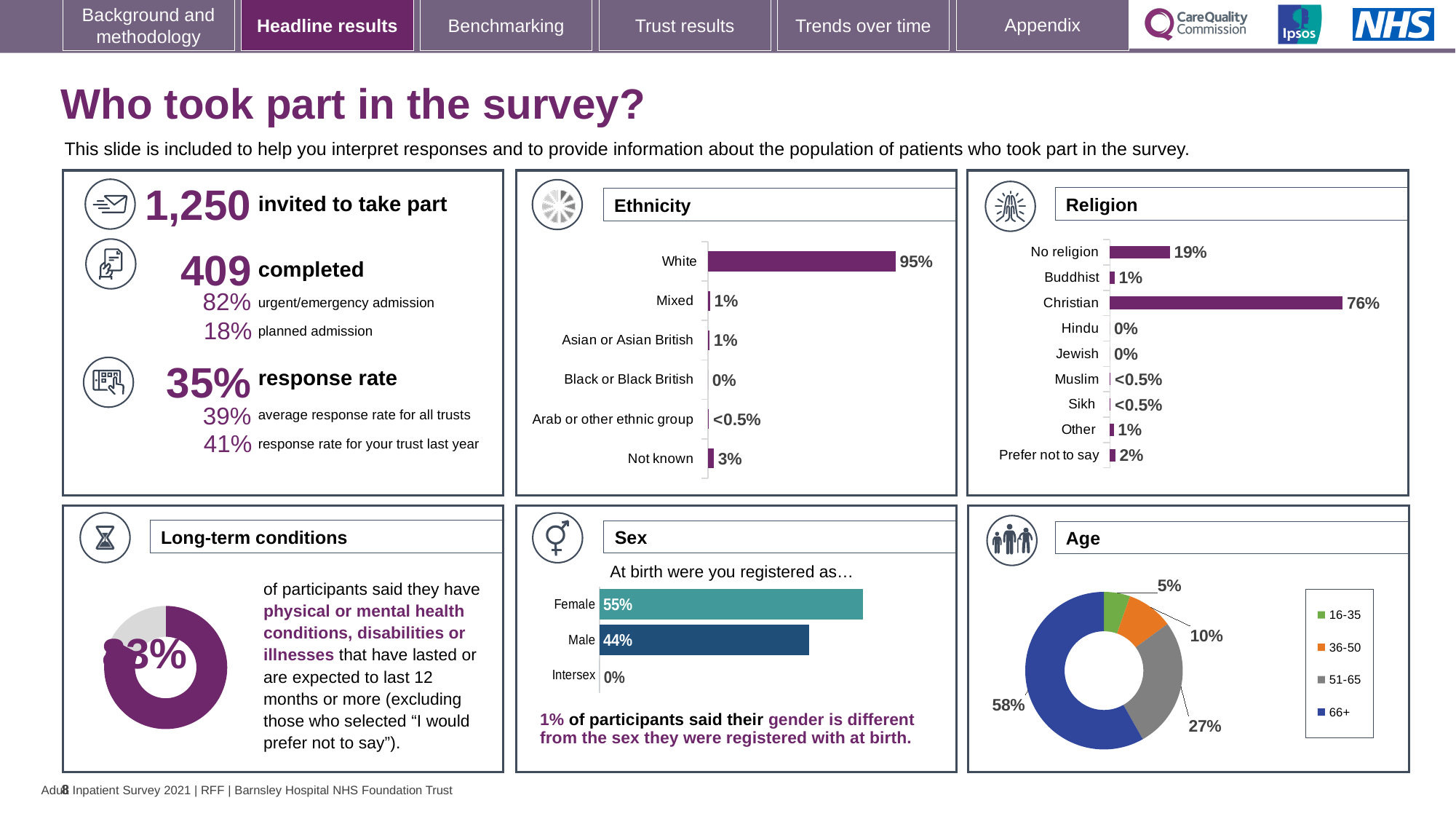
In the Ethnicity chart, what is the value for White? 95% In the Religion chart, what is the difference between Christian and No religion? 57% In the Religion chart, what is the value for Prefer not to say? 2% How many age groups does the legend of the Age chart list? 4 In the Religion chart, what is the value for Christian? 76% In the Sex chart, which is larger, Female or Male? Female In the Age chart, what share of participants are aged 66+? 58% In the Ethnicity chart, what is the value for Not known? 3% How many categories does the Ethnicity chart show? 6 What kind of chart is the Religion chart? Bar chart In the Ethnicity chart, which category has the highest value? White In the Sex chart, what is the value for Male? 44%